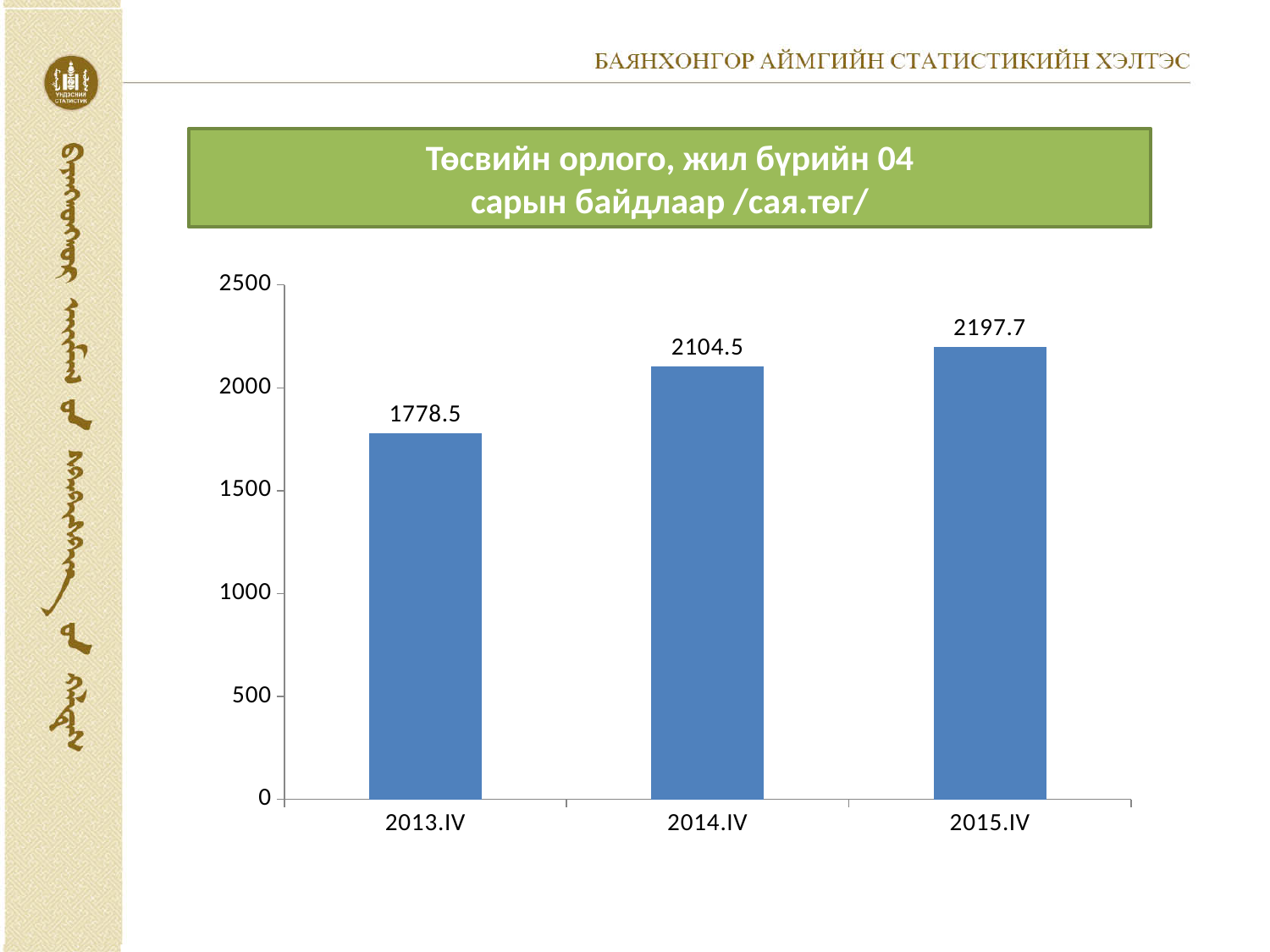
Which category has the highest value? 2015.IV Do the values rise or fall from 2013.IV to 2015.IV? rise Is the value for 2013.IV greater or less than 2000? less What is the value for 2013.IV? 1778.5 Which category has the lowest value? 2013.IV How many categories are shown on the x axis? 3 What is the value for 2014.IV? 2104.5 What kind of chart is shown on the slide? bar chart Which is larger, the value for 2014.IV or the value for 2015.IV? 2015.IV What is the value for 2015.IV? 2197.7 What is the difference between the values for 2015.IV and 2013.IV? 419.2 What is the difference between the values for 2014.IV and 2013.IV? 326